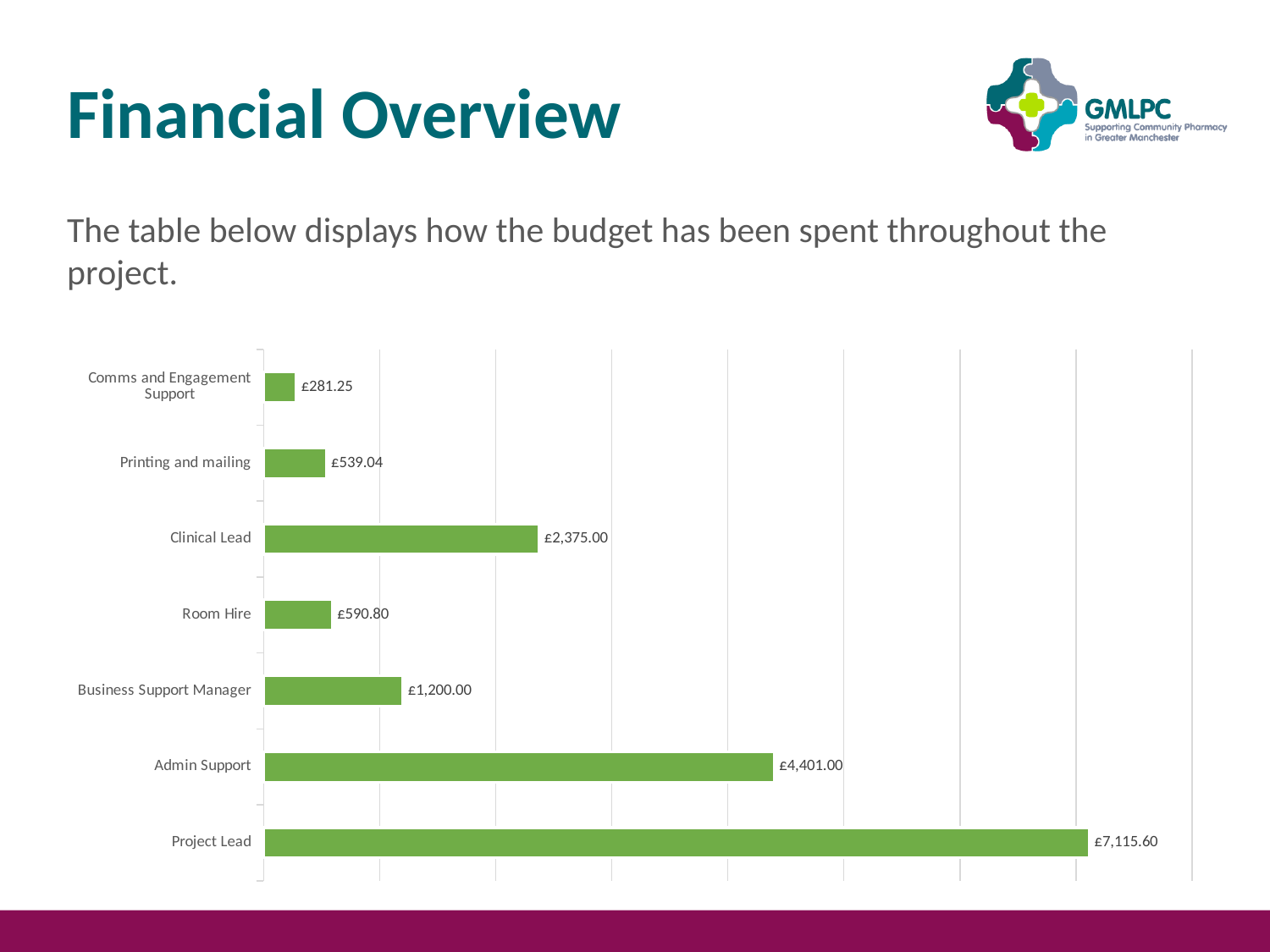
What is the value for Admin Support? £4,401.00 Which category has the lowest value? Comms and Engagement Support How many categories are shown in the chart? 7 What is the difference between the values for Room Hire and Printing and mailing? £51.76 What is the value for Clinical Lead? £2,375.00 What is the value for Project Lead? £7,115.60 What is the value for Printing and mailing? £539.04 Which category has the highest value? Project Lead What is the difference between the values for Project Lead and Admin Support? £2,714.60 What colour are the bars in the chart? Green What kind of chart is shown on the slide? Bar chart Which is larger, the value for Business Support Manager or the value for Room Hire? Business Support Manager